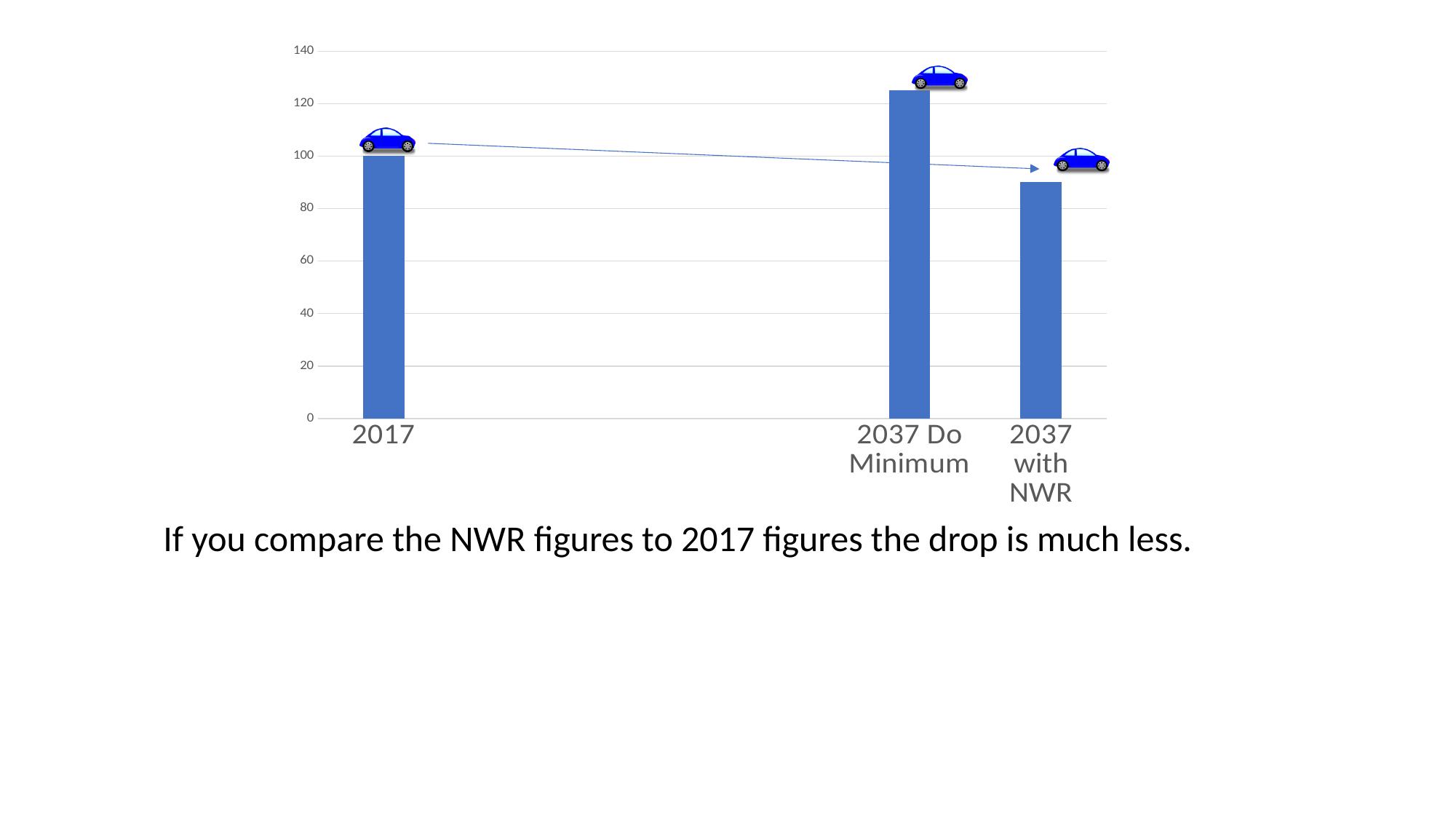
What does the text below the chart say? If you compare the NWR figures to 2017 figures the drop is much less. What is the value for 2017? 100 Which category has the lowest bar? 2037 with NWR Which category has the highest bar? 2037 Do Minimum What kind of chart is shown on the slide? bar chart Is the value for 2037 with NWR greater or less than 100? less What is the highest value shown on the vertical axis? 140 Which is larger, the value for 2017 or the value for 2037 with NWR? 2017 Is the value for 2037 Do Minimum greater or less than 120? greater How many bars are plotted in the chart? 3 Which is larger, the value for 2037 Do Minimum or the value for 2017? 2037 Do Minimum Is the value for 2037 with NWR greater or less than 80? greater